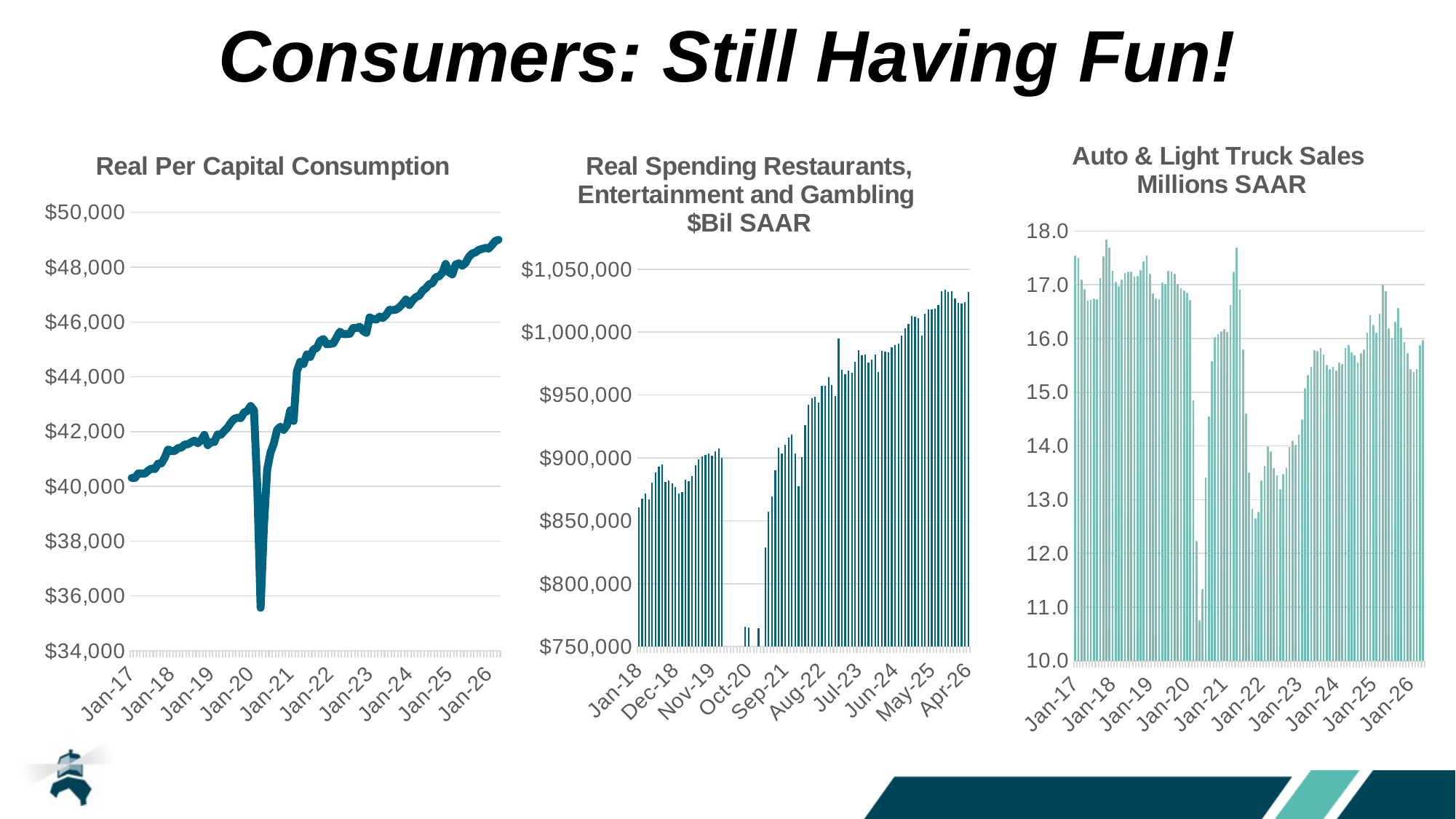
In the 'Real Per Capital Consumption' chart, is the value at Jan-26 greater or less than $48,000? greater In the 'Real Per Capital Consumption' chart, is the lowest point of the 2020 dip greater or less than $38,000? less What kind of chart is the middle chart, 'Real Spending Restaurants, Entertainment and Gambling'? bar chart What kind of chart is the 'Real Per Capital Consumption' chart on the left? line chart In the 'Real Spending Restaurants, Entertainment and Gambling' chart, is the value at Jan-18 greater or less than $900,000? less In the 'Real Per Capital Consumption' chart, do values overall rise or fall from Jan-17 to Jan-26? rise What kind of chart is the 'Auto & Light Truck Sales' chart on the right? bar chart How many charts are shown on the slide? 3